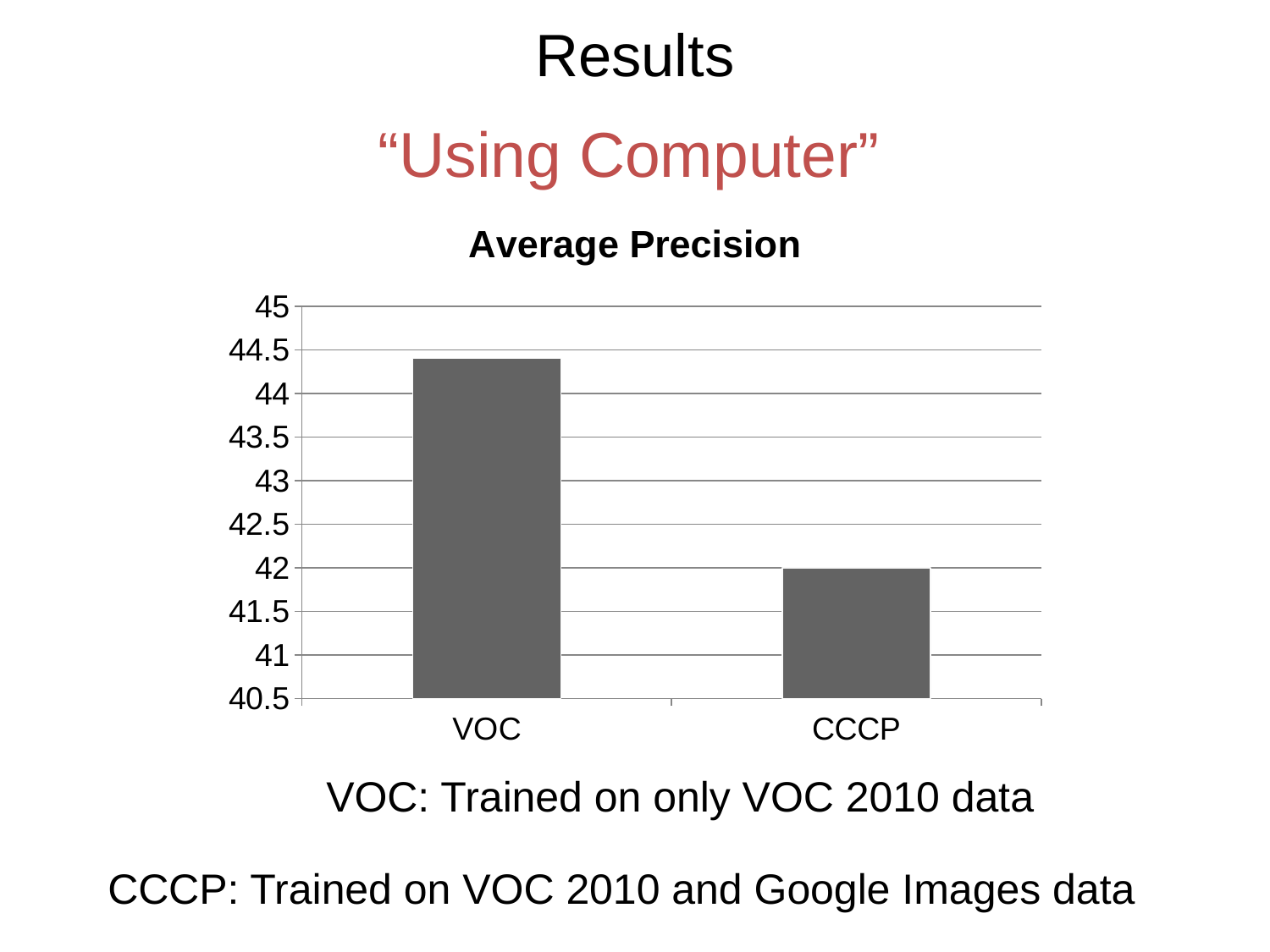
What is the lowest value shown on the vertical axis? 40.5 Which category has the lowest average precision? CCCP What is the average precision value for CCCP? 42 Is the value for CCCP greater or less than 43? less What is the title of the chart? Average Precision Which has a larger average precision, VOC or CCCP? VOC What type of chart is shown on the slide? bar chart Which category has the highest average precision? VOC Is the value for VOC greater or less than 44? greater How many categories are plotted in the chart? 2